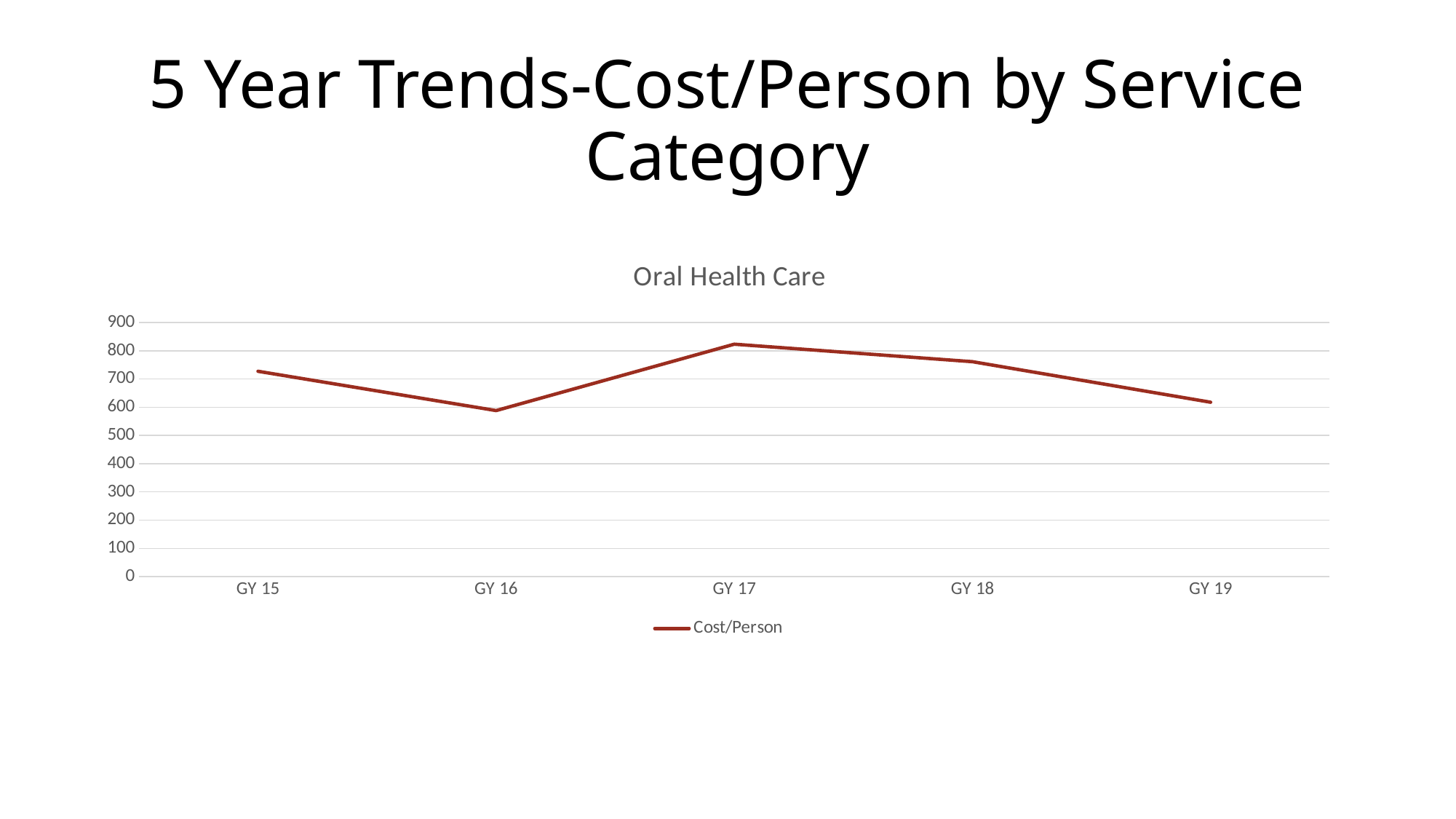
Is the Cost/Person for GY 15 greater or less than 700? greater Which grant year has the highest Cost/Person? GY 17 What is the name of the series shown in the legend? Cost/Person Is the Cost/Person for GY 16 greater or less than 700? less What kind of chart is shown on the slide? line chart Which grant year has the lowest Cost/Person? GY 16 Is the Cost/Person for GY 17 greater or less than 800? greater How many grant years are plotted on the x axis? 5 Does the Cost/Person rise or fall from GY 17 to GY 19? fall Which is larger, the Cost/Person for GY 15 or for GY 19? GY 15 What is the title of the chart? Oral Health Care How many series does the legend list? 1